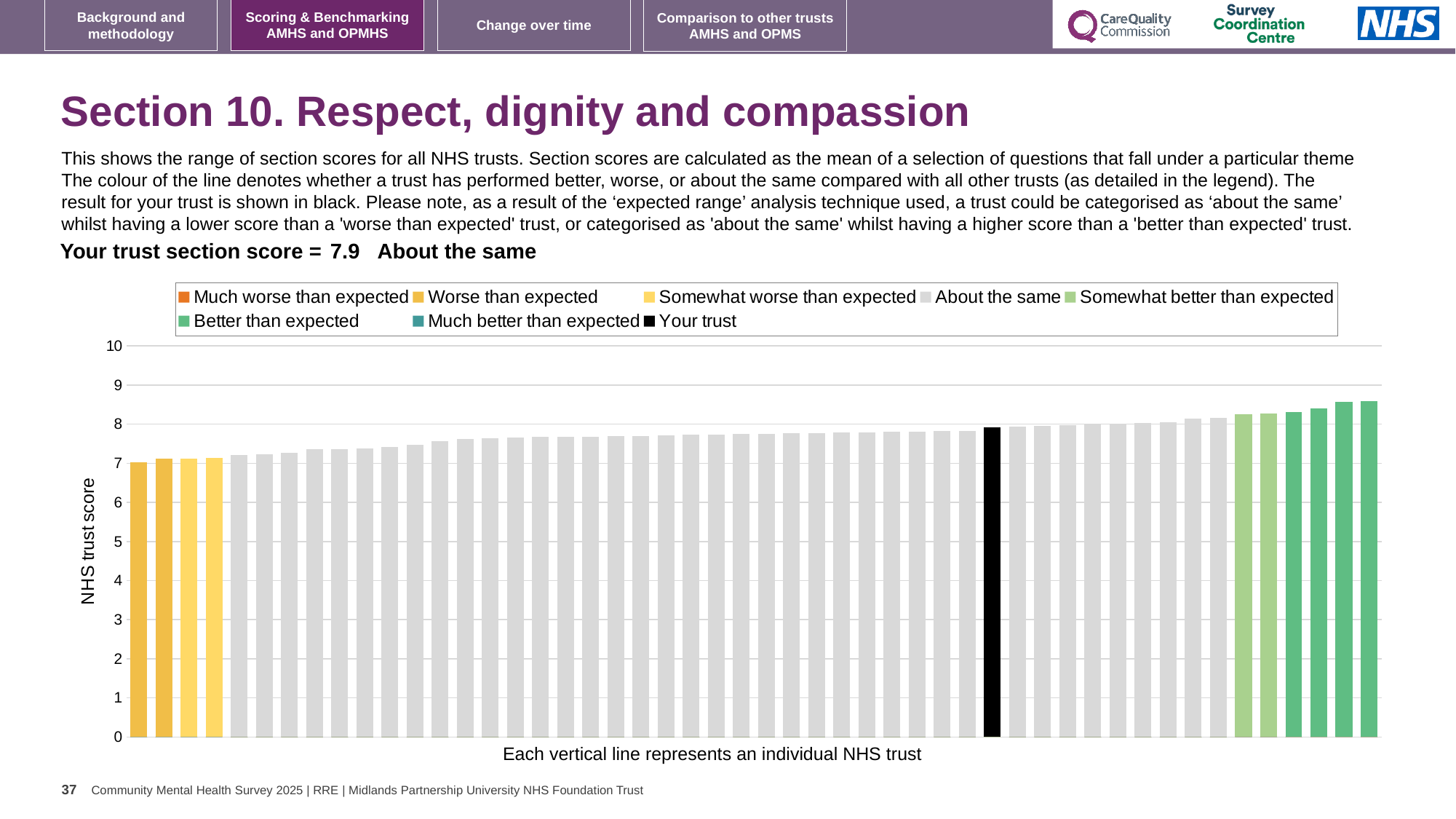
What does each vertical line on the chart represent, according to the x-axis label? An individual NHS trust Is the value of the lowest bar on the chart greater or less than 6? greater What is the section score for your trust shown on the slide? 7.9 Is the value of the highest bar on the chart greater or less than 8? greater Is the value of the black 'Your trust' bar greater or less than 7? greater What is the label on the vertical axis of the chart? NHS trust score Do the bar values rise or fall from left to right along the x axis? rise What kind of chart is shown on the slide? bar chart Which category is your trust placed in for this section? About the same How many bars on the chart are coloured black? 1 How many entries does the chart legend list? 8